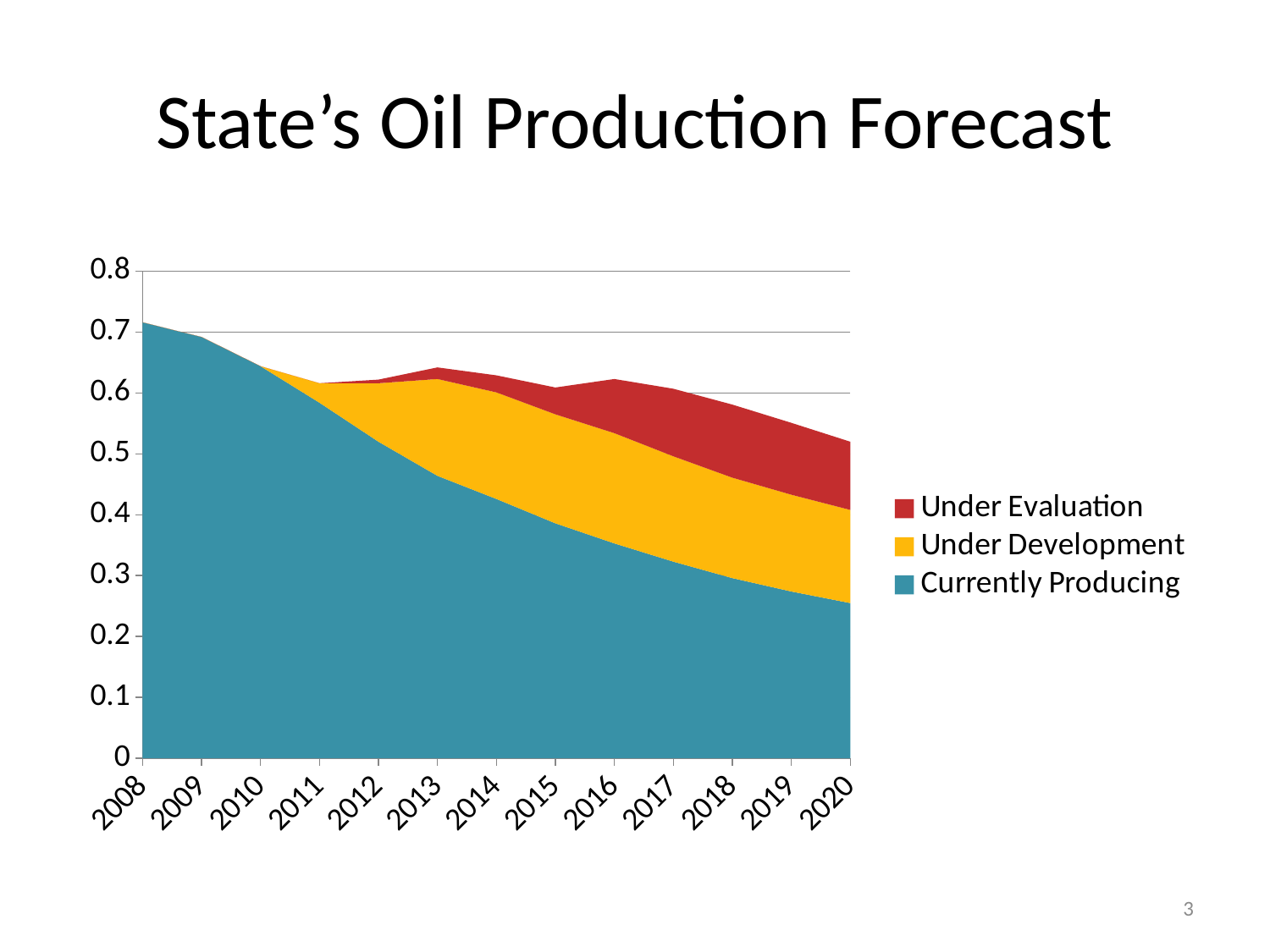
How many series does the legend list? 3 What kind of chart is shown on the slide? stacked area chart How many years are shown along the x axis? 13 Does the Currently Producing series rise or fall from 2008 to 2020? fall In which year is the Currently Producing value lowest? 2020 Which series is shown in red in the legend? Under Evaluation In which year is the Currently Producing value highest? 2008 Is the Currently Producing value for 2013 greater or less than 0.5? less Is the total stacked value for 2020 greater or less than 0.5? greater What is the title of the slide containing the chart? State's Oil Production Forecast Which year has the larger Currently Producing value, 2008 or 2020? 2008 Is the Currently Producing value for 2020 greater or less than 0.3? less